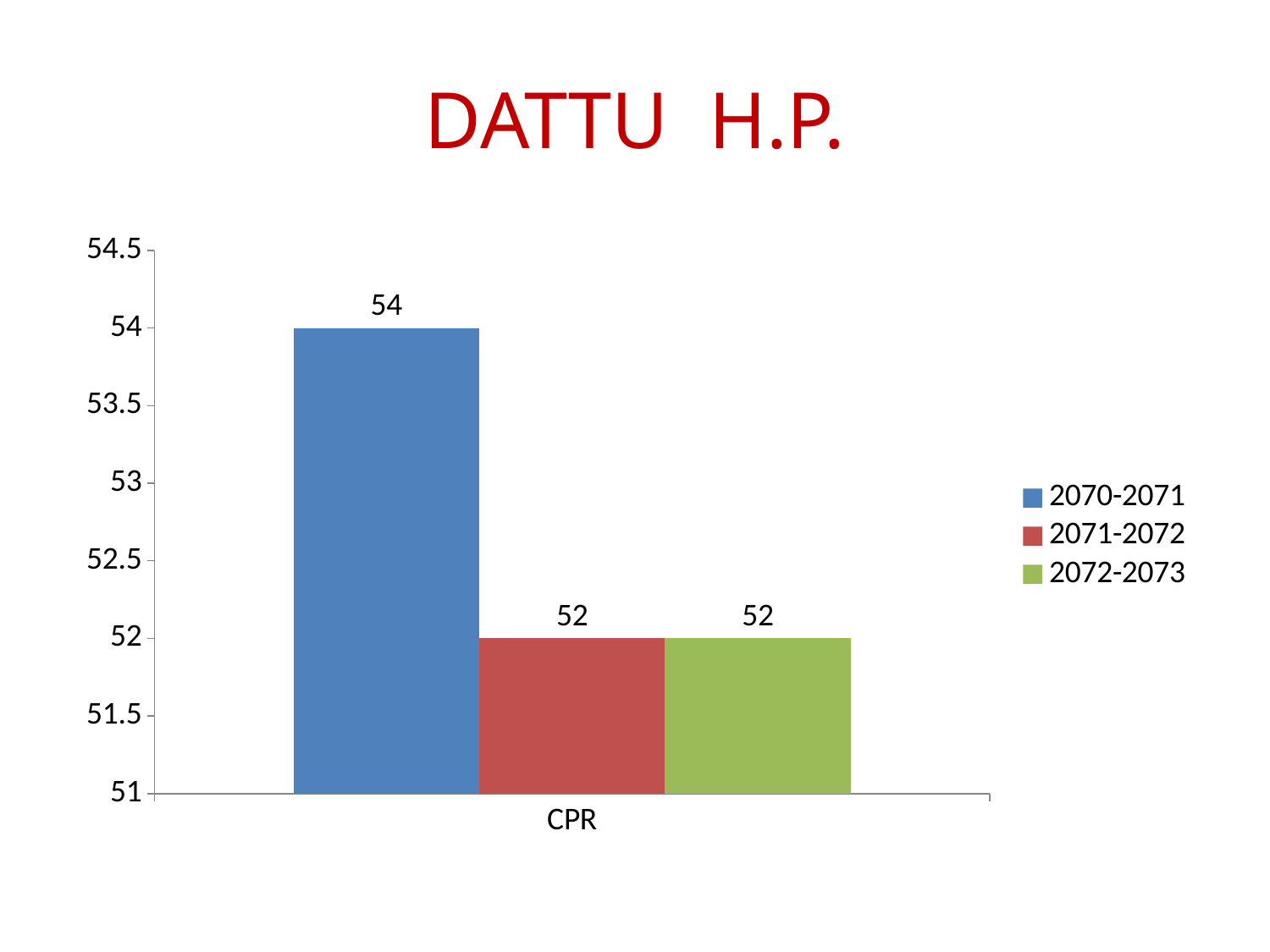
What is the category label on the x axis of the chart? CPR Which is larger, the CPR value for 2070-2071 or for 2072-2073? 2070-2071 What is the CPR value for 2070-2071? 54 Which series has the highest CPR value? 2070-2071 Is the CPR value for 2071-2072 greater or less than 53? less Is the CPR value for 2070-2071 greater or less than 53? greater How many series does the legend list? 3 What is the difference between the CPR values for 2070-2071 and 2071-2072? 2 What kind of chart is shown on the slide? bar chart What is the CPR value for 2072-2073? 52 What is the CPR value for 2071-2072? 52 What colour is the bar for 2072-2073? green